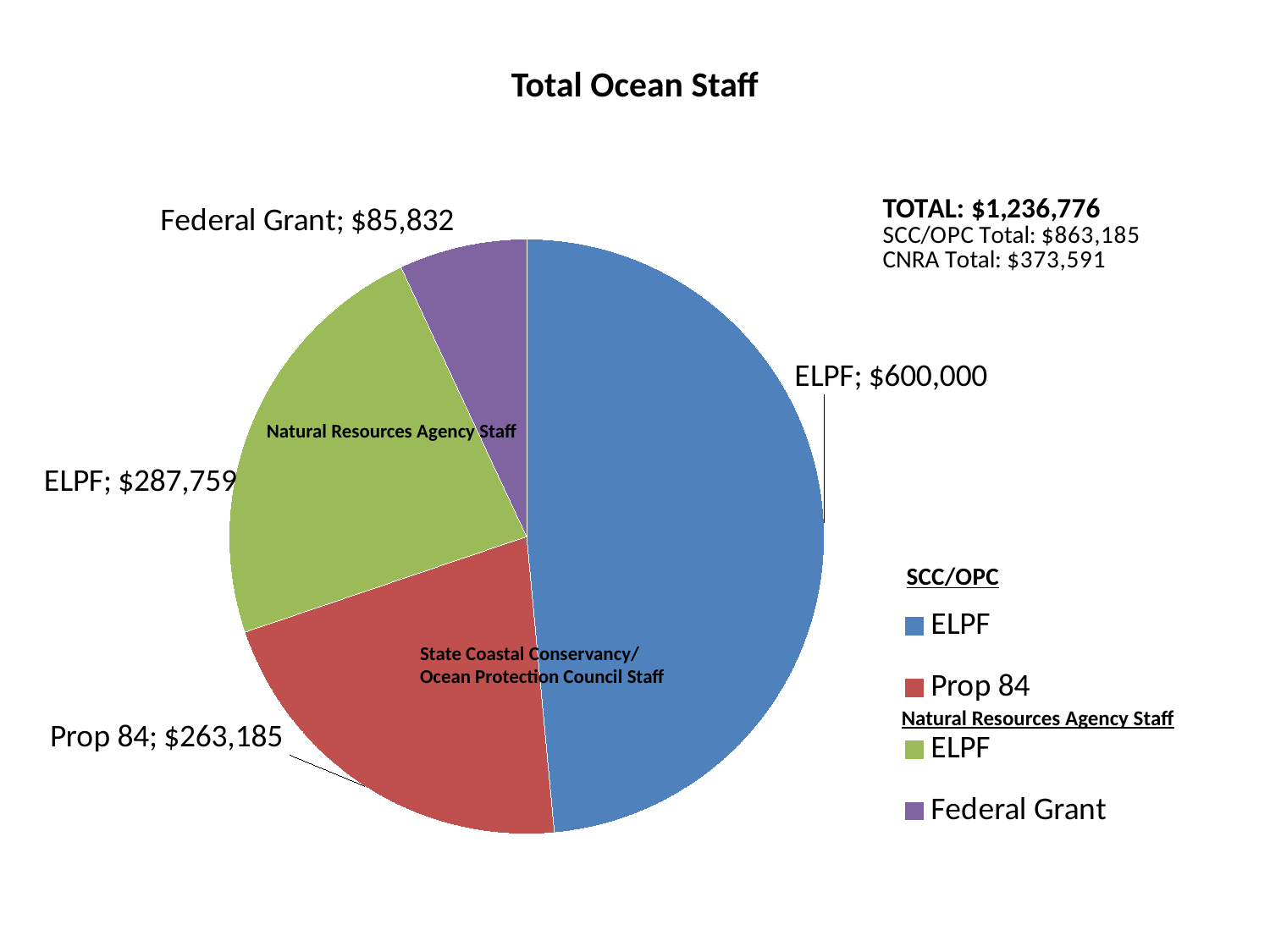
What is the value of the Natural Resources Agency Staff ELPF slice? $287,759 How many slices does the pie chart have? 4 What is the value of the Prop 84 slice? $263,185 What is the title of the chart? Total Ocean Staff What is the difference between the SCC/OPC ELPF slice and the Prop 84 slice? $336,815 Which is larger, the Natural Resources Agency Staff ELPF slice or the Prop 84 slice? Natural Resources Agency Staff ELPF How many entries does the legend list? 4 Which slice of the pie is the largest? ELPF (SCC/OPC), $600,000 What type of chart is shown on the slide? pie chart What is the value of the Federal Grant slice? $85,832 Which slice of the pie is the smallest? Federal Grant What is the value of the SCC/OPC ELPF slice? $600,000